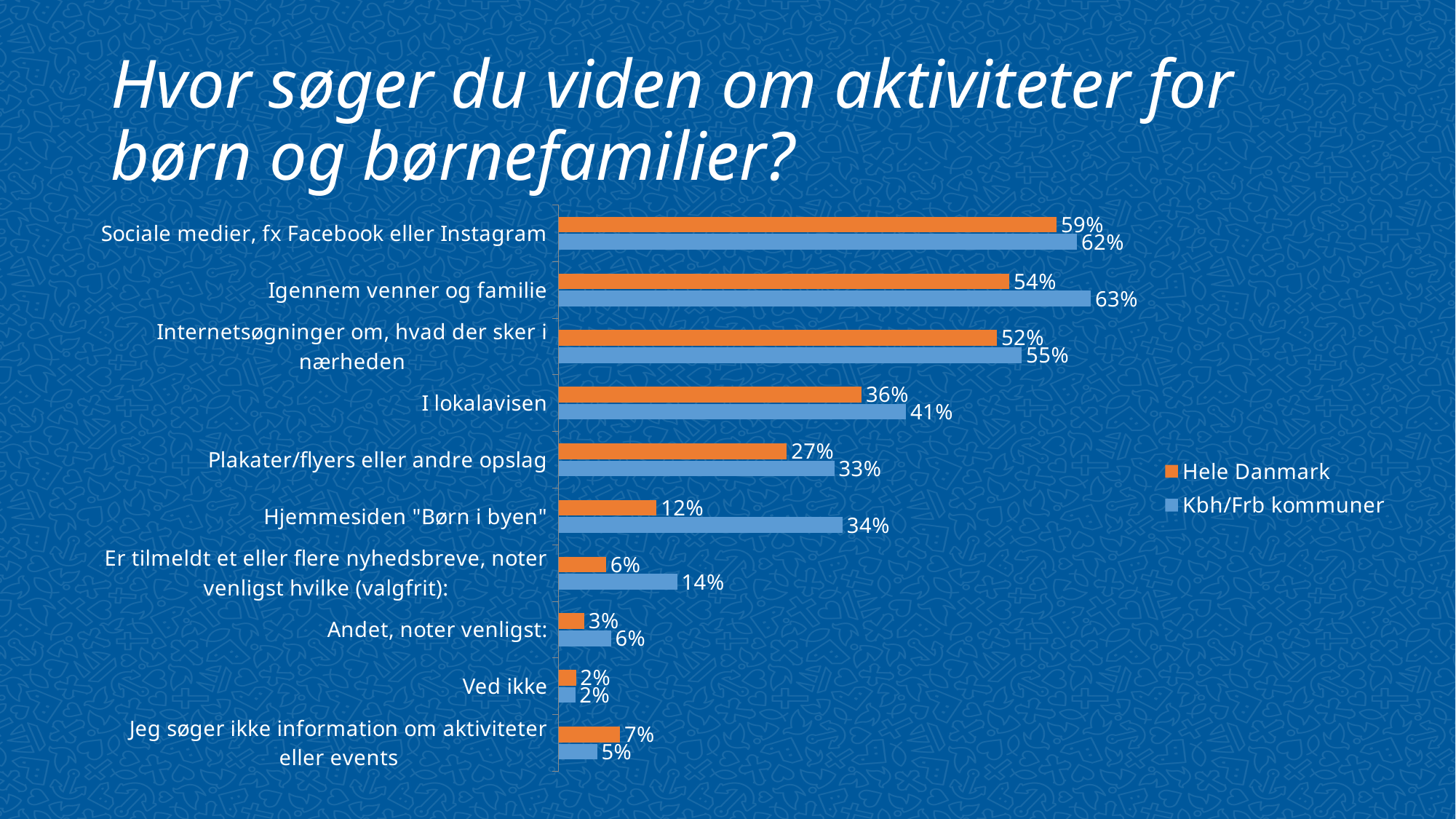
What is the value for Hele Danmark for "I lokalavisen"? 36% Which is larger for "Jeg søger ikke information om aktiviteter eller events": Hele Danmark or Kbh/Frb kommuner? Hele Danmark Which category has the lowest value for Hele Danmark? Ved ikke What kind of chart is shown on the slide? Bar chart What is the value for Hele Danmark for "Sociale medier, fx Facebook eller Instagram"? 59% Which colour represents Hele Danmark in the chart? Orange How many categories are shown in the chart? 10 What is the value for Kbh/Frb kommuner for "Igennem venner og familie"? 63% How many series does the legend list? 2 What is the difference between the Kbh/Frb kommuner and Hele Danmark values for "Hjemmesiden "Børn i byen""? 22% Which category has the highest value for Kbh/Frb kommuner? Igennem venner og familie What is the value for Kbh/Frb kommuner for "Hjemmesiden "Børn i byen""? 34%